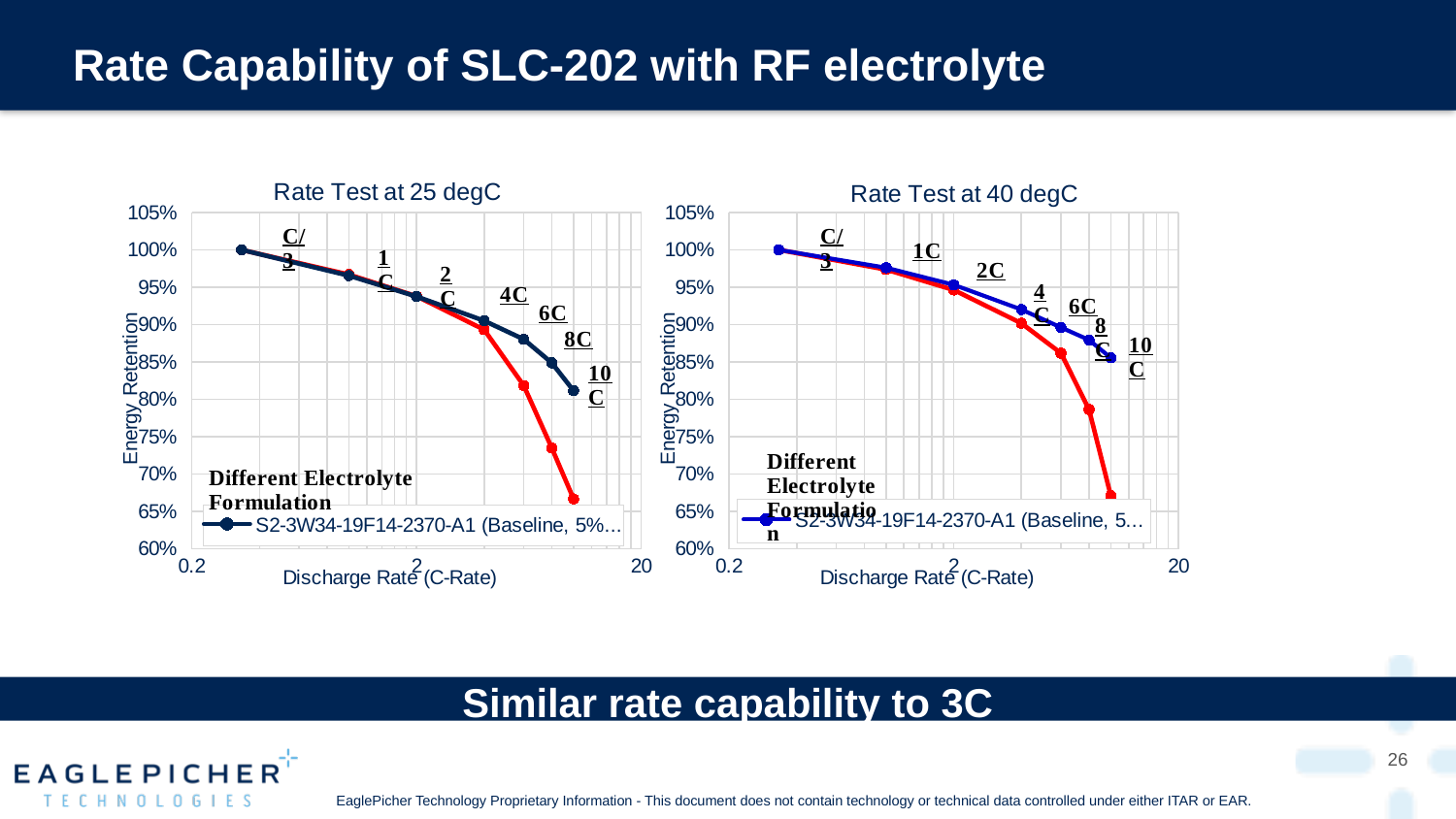
What is the x-axis label of the "Rate Test at 40 degC" chart? Discharge Rate (C-Rate) What kind of chart is the "Rate Test at 40 degC" chart? line chart How many labeled C-rate points are shown on the "Rate Test at 25 degC" chart? 7 In the "Rate Test at 40 degC" chart, does energy retention rise or fall as the discharge rate increases? fall In the "Rate Test at 40 degC" chart, is the energy retention of the blue baseline line at 10C greater or less than 80%? greater In the "Rate Test at 25 degC" chart, is the energy retention of the red (Different Electrolyte Formulation) line at 10C greater or less than 70%? less In the "Rate Test at 25 degC" chart, is the energy retention of the dark blue baseline line at 10C greater or less than 75%? greater What kind of chart is the "Rate Test at 25 degC" chart? line chart In the "Rate Test at 40 degC" chart, which line has the higher energy retention at 10C, the blue baseline or the red Different Electrolyte Formulation? blue baseline In the "Rate Test at 25 degC" chart, which line has the higher energy retention at 8C, the dark blue baseline or the red Different Electrolyte Formulation? dark blue baseline In the "Rate Test at 25 degC" chart, does energy retention rise or fall as the discharge rate increases? fall